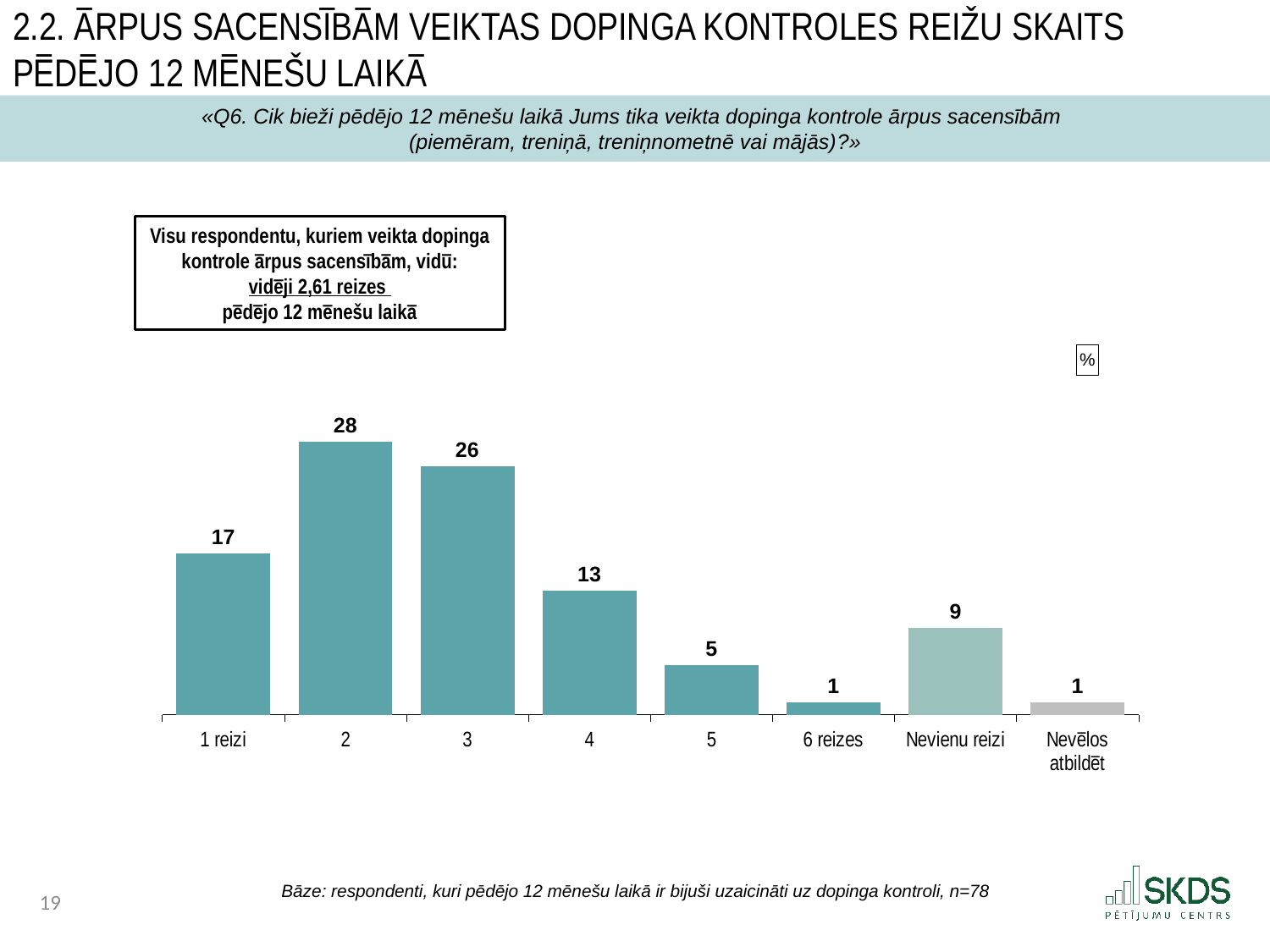
What is the difference between the values for "2" and "3"? 2 Which category has the highest value? 2 Which categories share the lowest value? 6 reizes and Nevēlos atbildēt What is the difference between the values for "5" and "6 reizes"? 4 What kind of chart is shown on the slide? bar chart What is the value for the category "Nevienu reizi"? 9 What is the value for the category "1 reizi"? 17 What is the value for the category "Nevēlos atbildēt"? 1 What is the value for the category "4"? 13 How many categories are shown on the x axis? 8 What unit is indicated in the small box above the chart? % Which is larger, the value for "1 reizi" or the value for "4"? 1 reizi